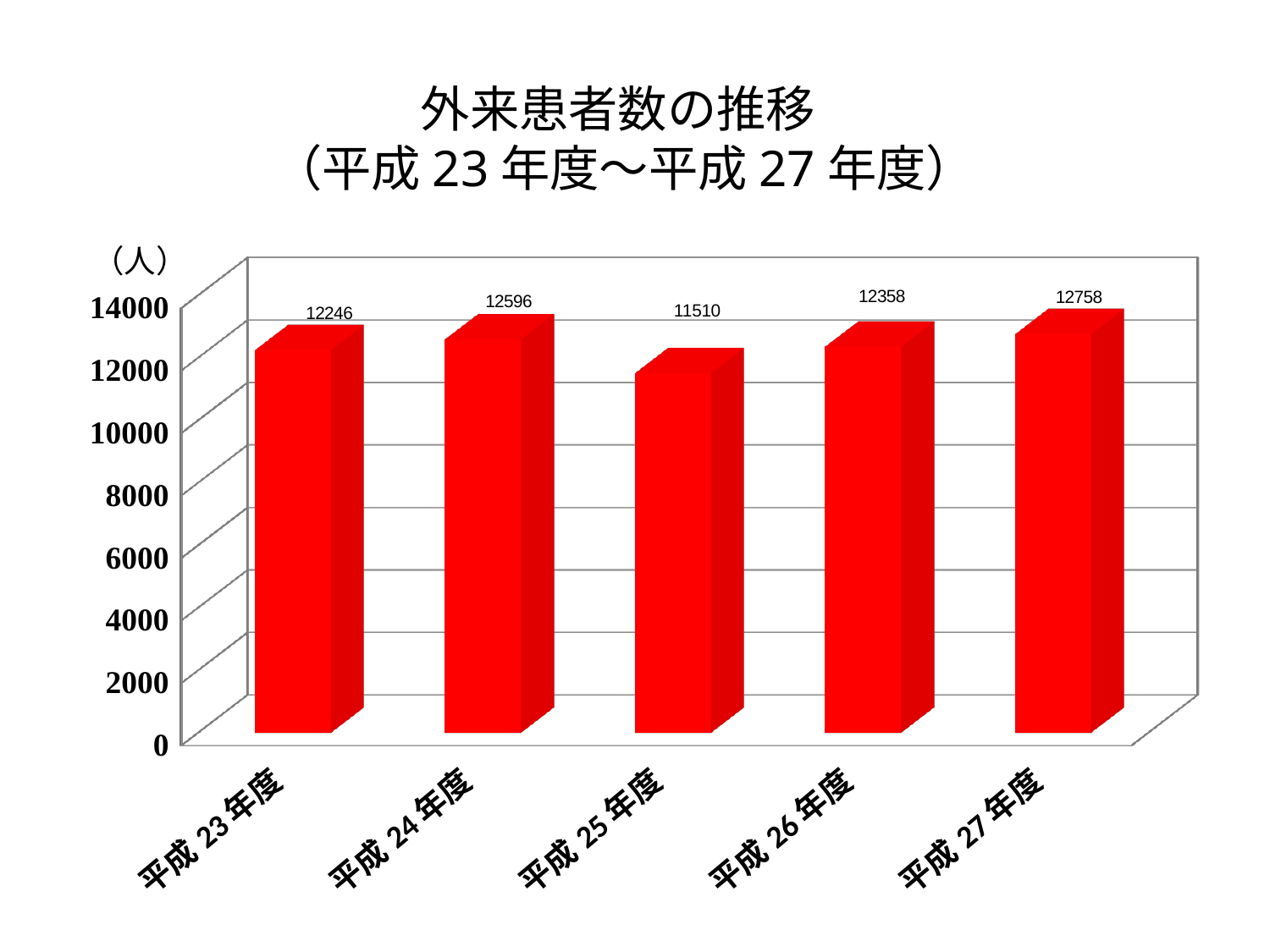
What kind of chart is this? bar chart How many years are shown on the chart? 5 What is the value for 平成23年度? 12246 What is the value for 平成25年度? 11510 What is the value for 平成27年度? 12758 Which year has the lowest number of outpatients? 平成25年度 What is the difference between the values for 平成27年度 and 平成25年度? 1248 Which is larger, the value for 平成24年度 or 平成26年度? 平成24年度 What is the title of the chart? 外来患者数の推移（平成23年度～平成27年度） What is the difference between the values for 平成24年度 and 平成23年度? 350 Is the value for 平成25年度 greater or less than 12000? less Which year has the highest number of outpatients? 平成27年度